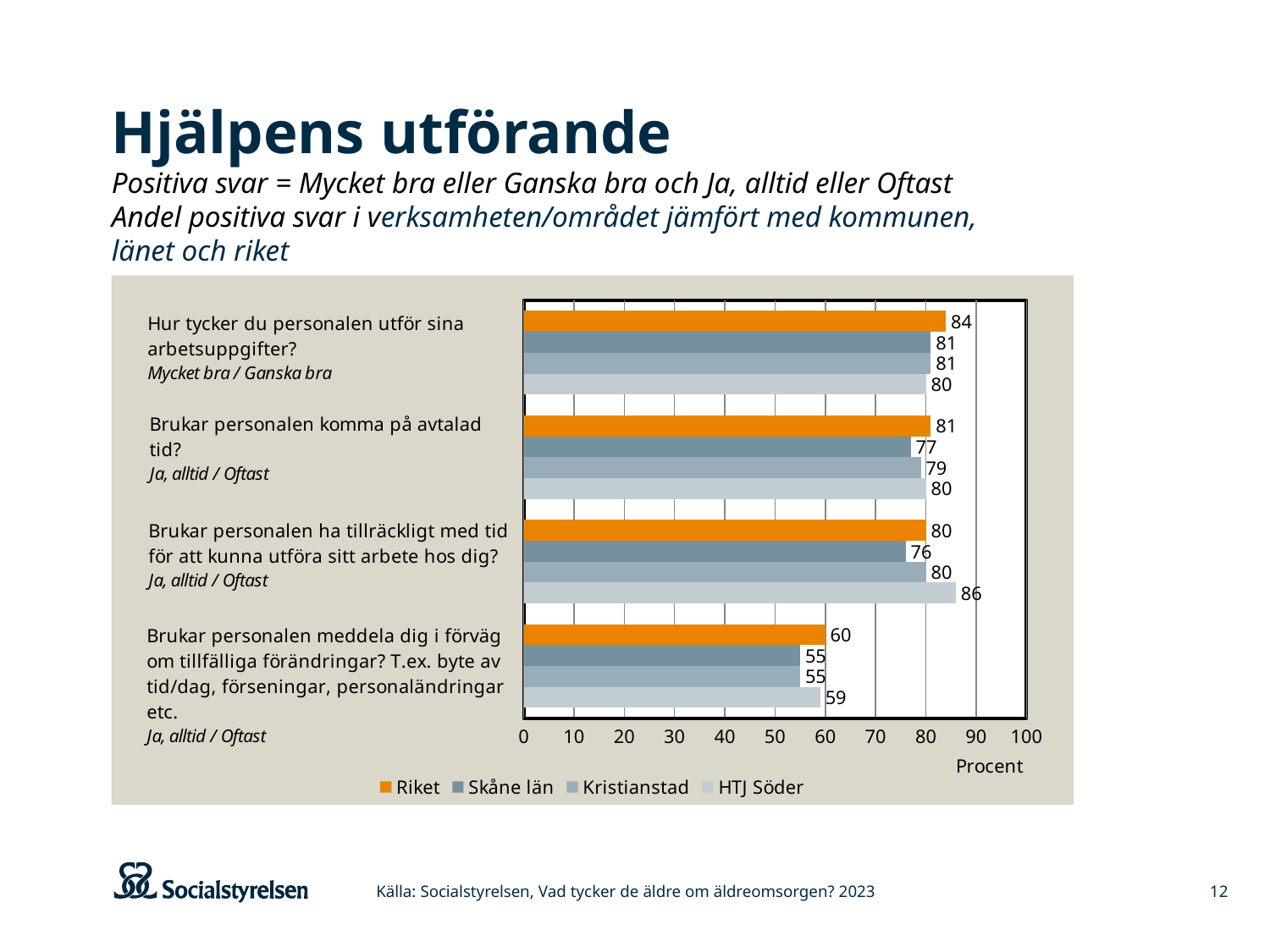
Which question has the lowest value for Riket? Brukar personalen meddela dig i förväg om tillfälliga förändringar? What is the value for Kristianstad on the question "Brukar personalen meddela dig i förväg om tillfälliga förändringar?"? 55 What is the value for HTJ Söder on the question "Brukar personalen ha tillräckligt med tid för att kunna utföra sitt arbete hos dig?"? 86 What is the value for Riket on the question "Hur tycker du personalen utför sina arbetsuppgifter?"? 84 Which is larger on the question "Brukar personalen komma på avtalad tid?": Kristianstad or HTJ Söder? HTJ Söder What is the difference between Riket and Skåne län on the question "Brukar personalen meddela dig i förväg om tillfälliga förändringar?"? 5 What is the label of the x axis? Procent How many questions (categories) are shown in the chart? 4 Which series has the highest value on the question "Brukar personalen ha tillräckligt med tid för att kunna utföra sitt arbete hos dig?"? HTJ Söder How many series does the legend list? 4 What kind of chart is shown on the slide? Bar chart What is the value for Skåne län on the question "Brukar personalen komma på avtalad tid?"? 77